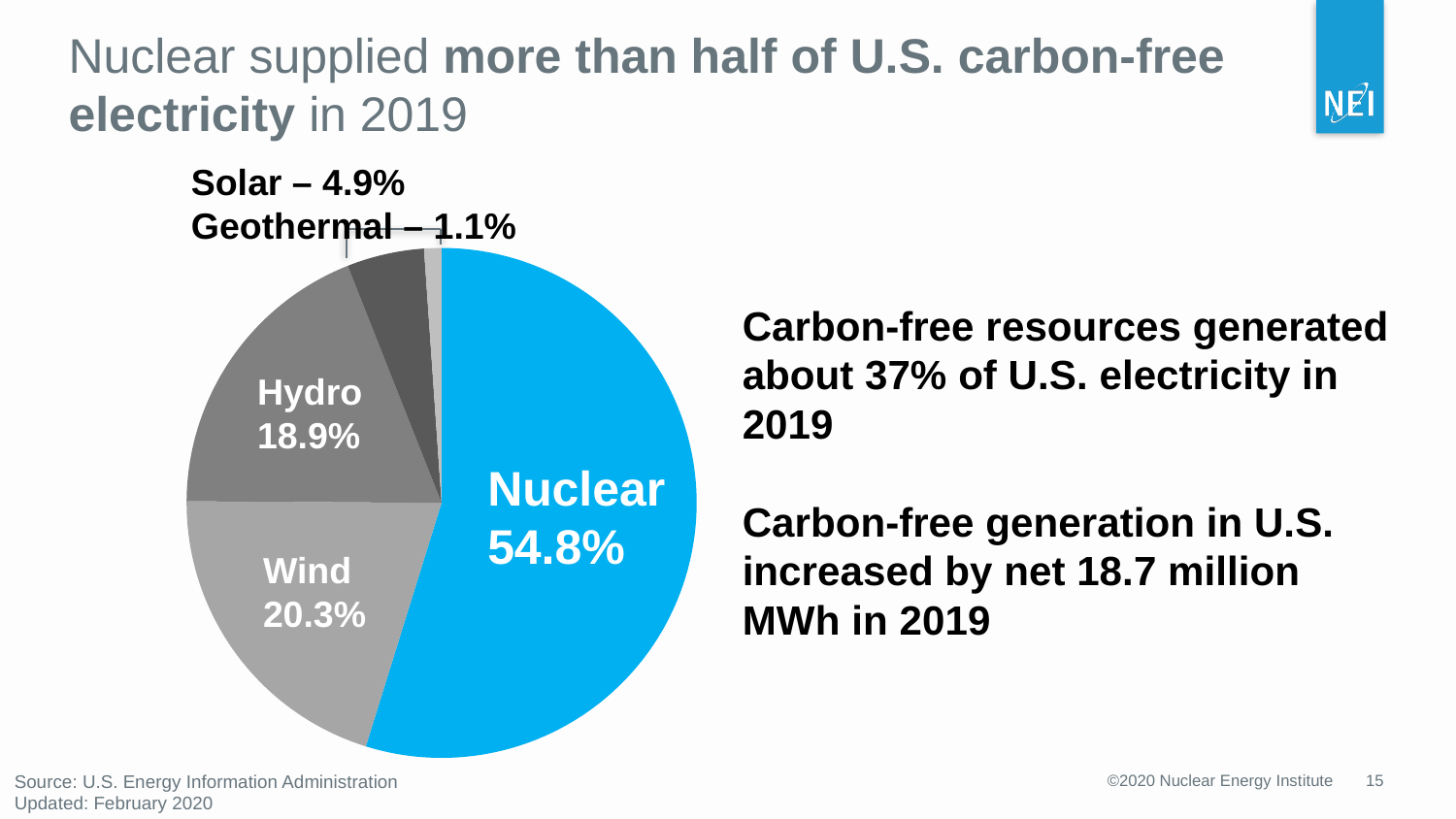
What is the value shown for Solar in the pie chart? 4.9% What colour is the Nuclear slice in the pie chart? Blue What share of U.S. carbon-free electricity did nuclear supply in 2019 according to the pie chart? 54.8% What is the difference between the Wind and Hydro shares in the pie chart? 1.4% What kind of chart is shown on the slide? Pie chart What is the value shown for Geothermal in the pie chart? 1.1% What is the value shown for Hydro in the pie chart? 18.9% Which source has the largest slice of the pie chart? Nuclear What is the value shown for Wind in the pie chart? 20.3% How many sources are shown in the pie chart? 5 Which source has the smallest slice of the pie chart? Geothermal Which is larger in the pie chart, the Nuclear share or the Wind share? Nuclear